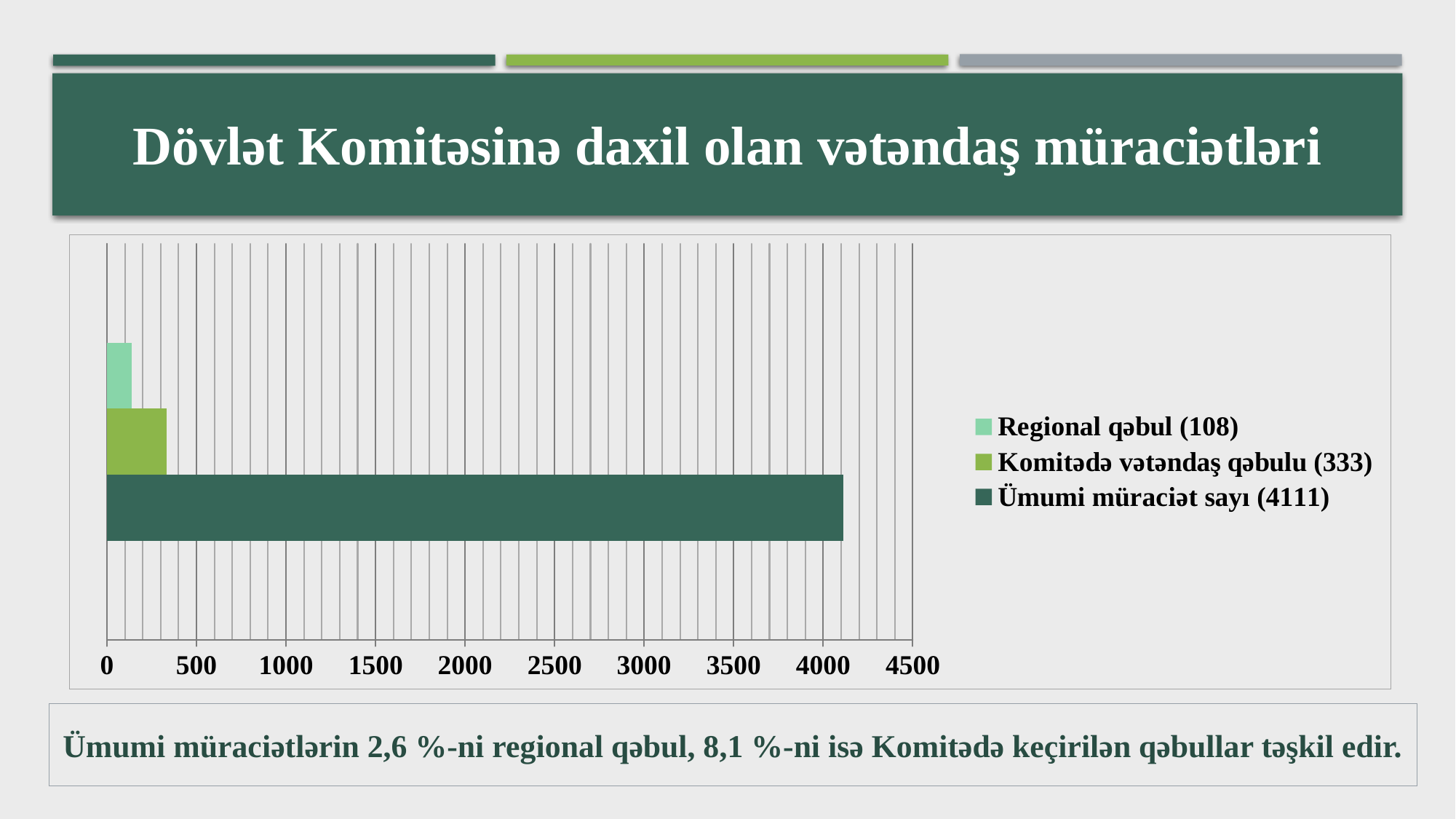
What is the difference between Komitədə vətəndaş qəbulu and Regional qəbul? 225 What is the title of the slide containing the chart? Dövlət Komitəsinə daxil olan vətəndaş müraciətləri Which series has the highest value? Ümumi müraciət sayı Which series has the lowest value? Regional qəbul Which is larger, Regional qəbul or Komitədə vətəndaş qəbulu? Komitədə vətəndaş qəbulu Is the value for Ümumi müraciət sayı greater or less than 4000? greater What kind of chart is shown on the slide? Bar chart What is the value for Komitədə vətəndaş qəbulu? 333 What is the value for Ümumi müraciət sayı? 4111 What is the value for Regional qəbul? 108 How many series does the legend list? 3 What is the difference between Ümumi müraciət sayı and Komitədə vətəndaş qəbulu? 3778